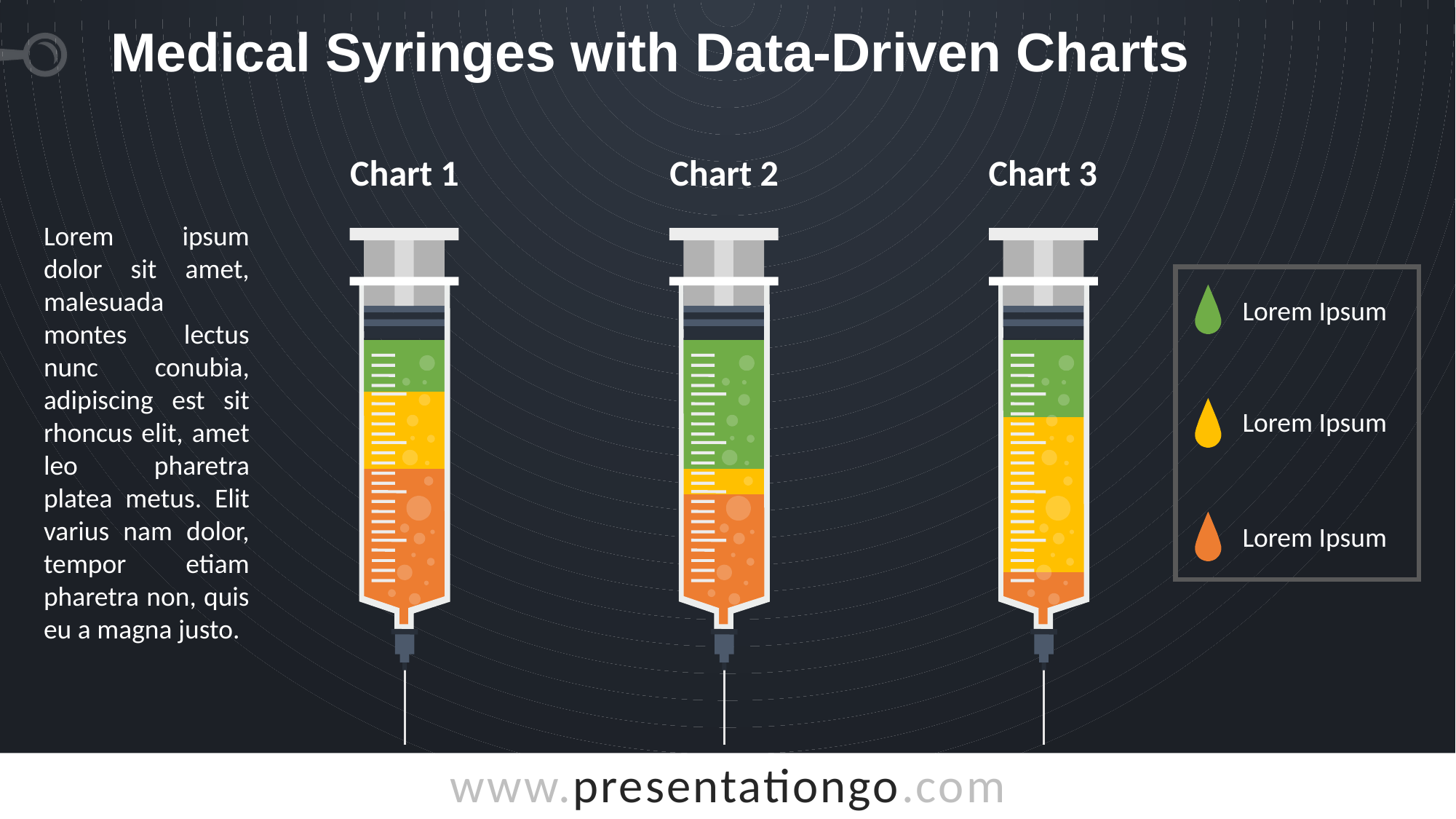
In Chart 3, which coloured segment is the largest? Yellow In Chart 2, which coloured segment is the smallest? Yellow In Chart 1, which coloured segment is the largest? Orange In Chart 1, which coloured segment is the smallest? Green In Chart 1, is the orange segment larger or smaller than the green segment? Larger How many entries does the legend on the right list? 3 How many syringe charts are shown on the slide? 3 What three colours are used for the segments in the syringe charts? Green, yellow, orange In Chart 3, which coloured segment is the smallest? Orange What kind of chart is each syringe on the slide? Stacked bar chart What are the titles of the three charts on the slide? Chart 1, Chart 2, Chart 3 In Chart 2, which coloured segment is the largest? Green